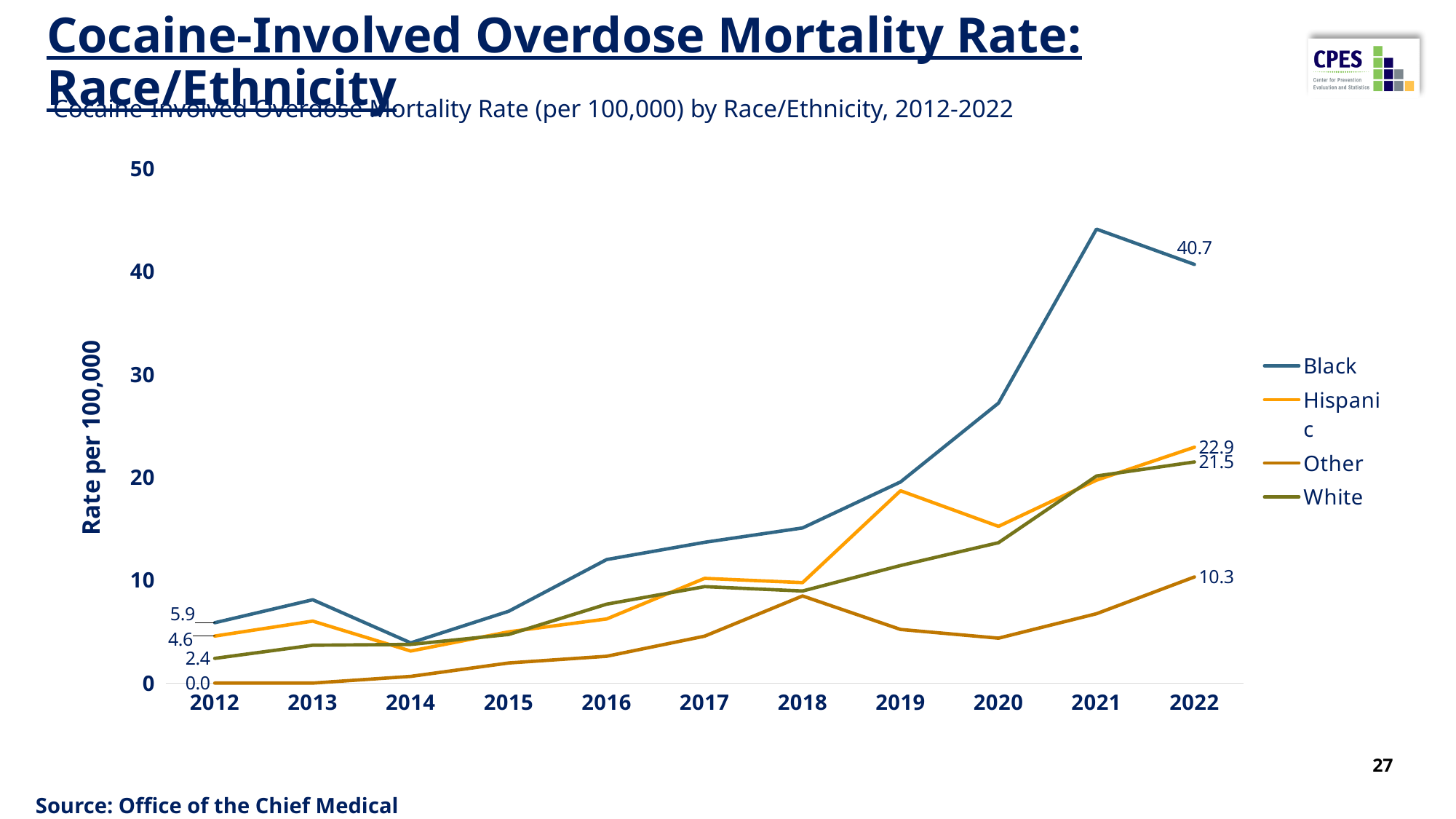
What was the rate for the White population in 2012? 2.4 How many series does the legend list? 4 What was the cocaine-involved overdose mortality rate for the Black population in 2022? 40.7 What was the rate for the Other group in 2022? 10.3 Is the rate for the Black population in 2021 greater or less than 40? greater Which race/ethnicity group had the highest rate in 2022? Black Which race/ethnicity group had the lowest rate in 2012? Other How many years are shown on the x axis? 11 What was the rate for the Hispanic population in 2012? 4.6 By how much did the rate for the Black population increase from 2012 to 2022? 34.8 What type of chart is shown on the slide? line chart In 2022, which group had a higher rate: Hispanic or White? Hispanic